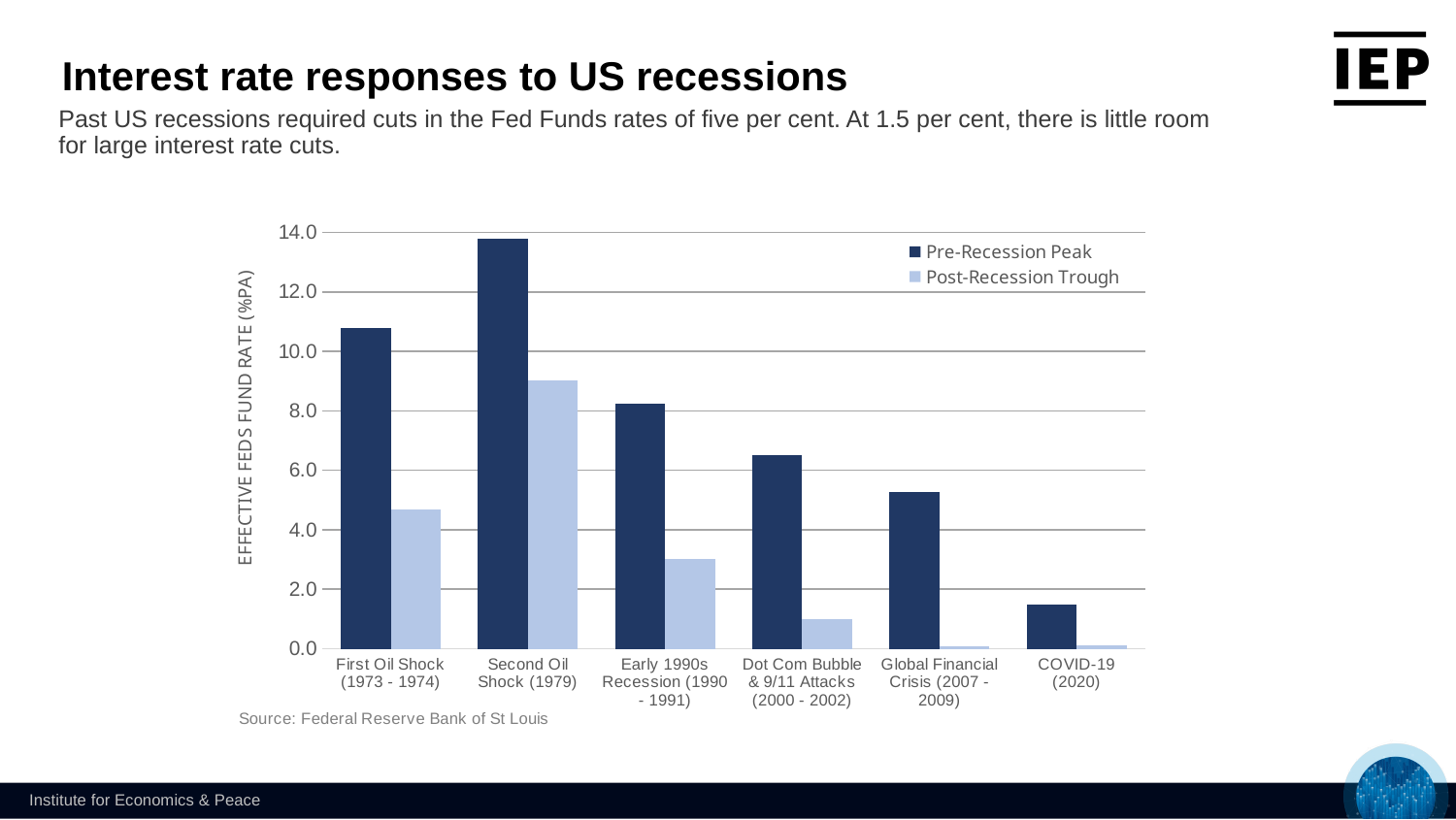
From the Second Oil Shock (1979) to COVID-19 (2020), do the Pre-Recession Peak values rise or fall? fall Which has the larger Pre-Recession Peak: the First Oil Shock (1973 - 1974) or the Early 1990s Recession (1990 - 1991)? First Oil Shock (1973 - 1974) How many recession categories are shown on the x axis? 6 Which recession has the lowest Pre-Recession Peak? COVID-19 (2020) Which recession has the highest Pre-Recession Peak? Second Oil Shock (1979) Is the Post-Recession Trough for the Global Financial Crisis (2007 - 2009) greater or less than 2.0? less Is the Pre-Recession Peak for the Dot Com Bubble & 9/11 Attacks (2000 - 2002) greater or less than 8.0? less How many series does the legend list? 2 Is the Post-Recession Trough for the Second Oil Shock (1979) greater or less than 8.0? greater Which recession has the highest Post-Recession Trough? Second Oil Shock (1979) What kind of chart is shown on the slide? Bar chart